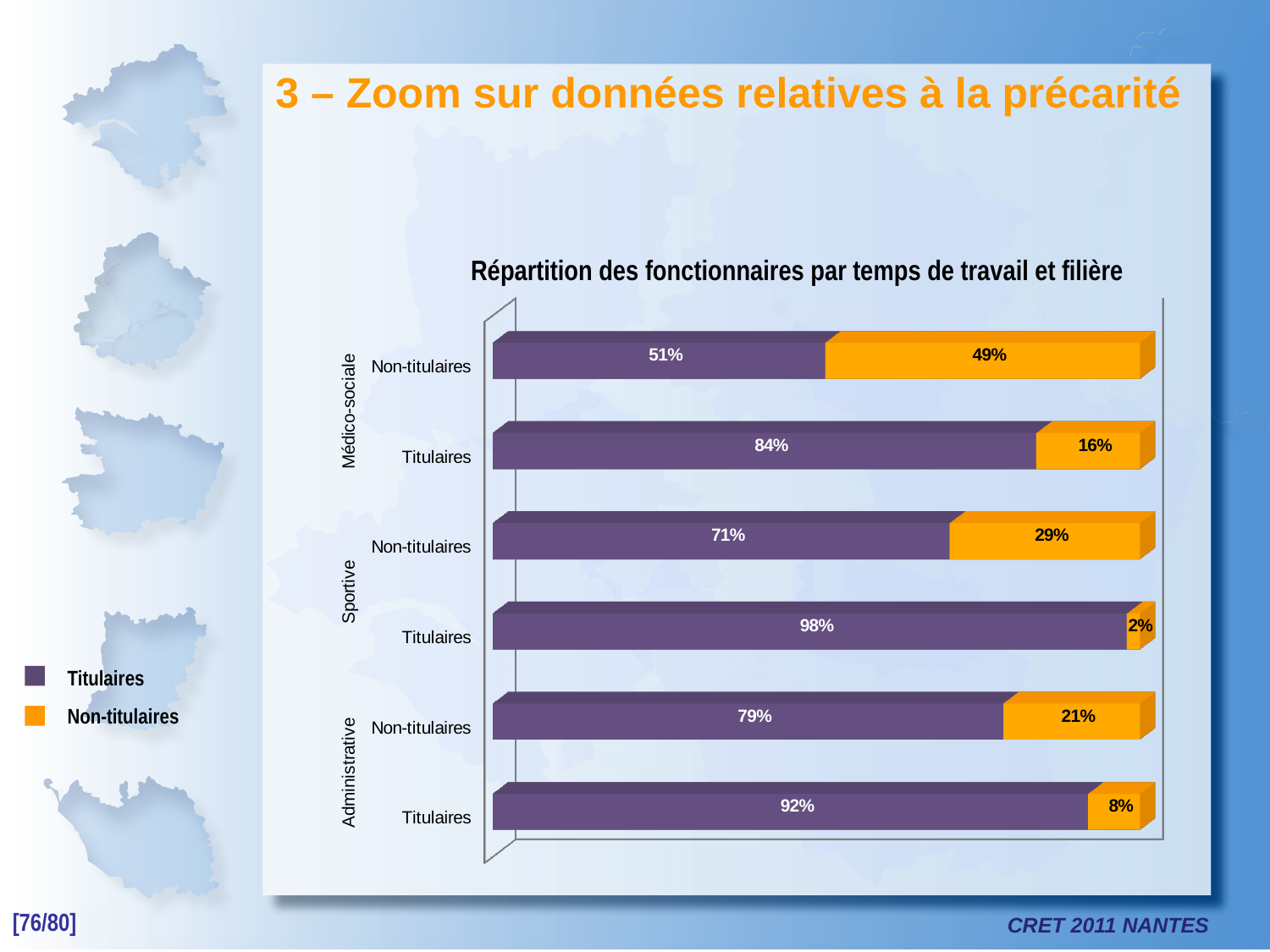
Which bar has the largest orange segment? Médico-sociale Non-titulaires How many bars are plotted in the chart? 6 What is the value of the purple segment for the Médico-sociale Non-titulaires bar? 51% How many series does the legend list? 2 What is the title of the chart? Répartition des fonctionnaires par temps de travail et filière What is the difference between the purple segment of the Sportive Titulaires bar and the purple segment of the Sportive Non-titulaires bar? 27% What is the total of the two segments in the Médico-sociale Non-titulaires bar? 100% What type of chart is shown on the slide? Stacked bar chart Which is larger: the orange segment of the Administrative Non-titulaires bar or the orange segment of the Médico-sociale Titulaires bar? Administrative Non-titulaires What is the value of the purple segment for the Administrative Titulaires bar? 92% What is the value of the orange segment for the Sportive Titulaires bar? 2% Which bar has the smallest orange segment? Sportive Titulaires